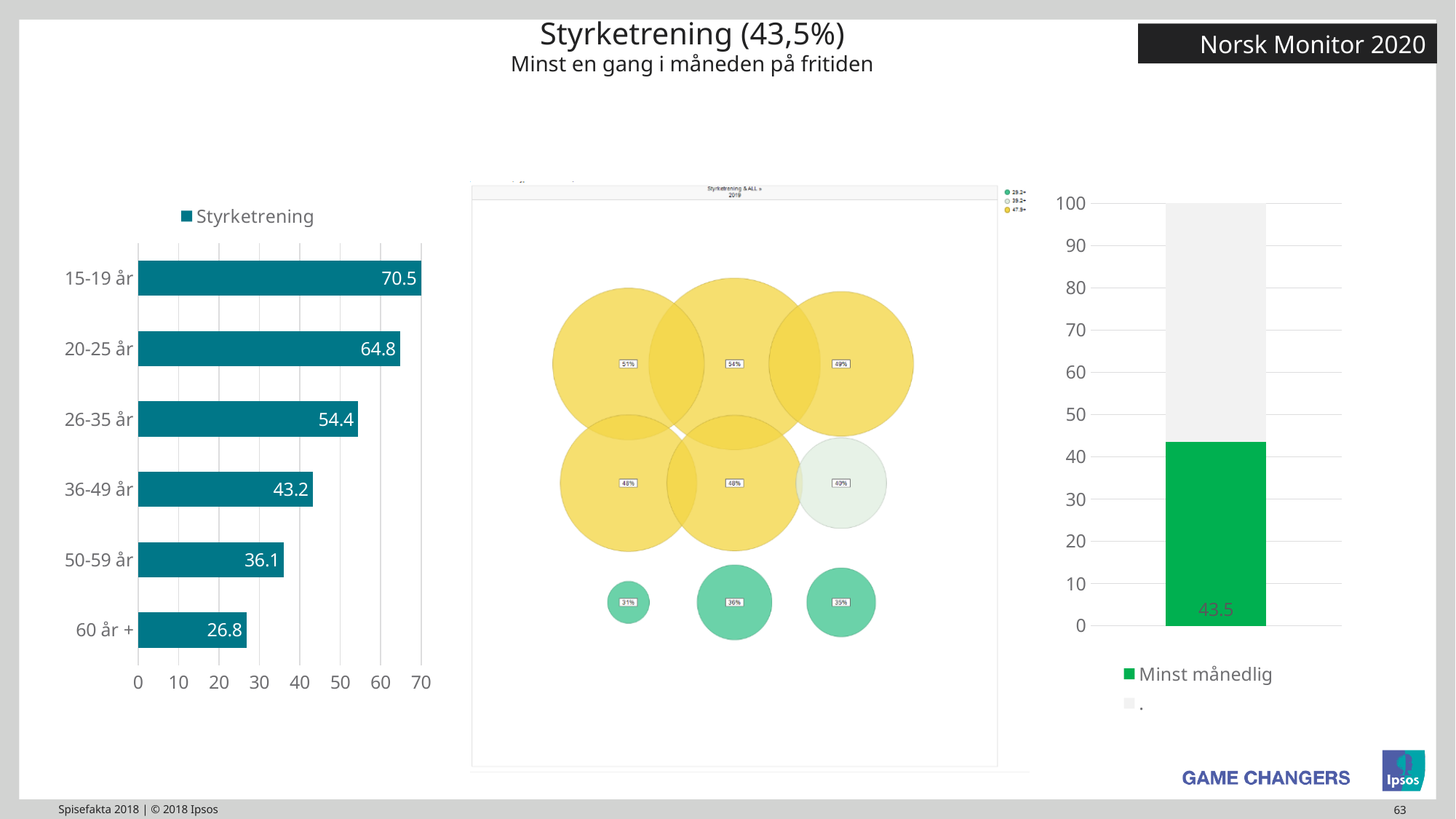
How many age groups are shown in the left bar chart? 6 In the left bar chart, what is the value for 60 år +? 26.8 What is the name of the series shown in the legend of the left bar chart? Styrketrening In the left bar chart, which is larger: the value for 50-59 år or the value for 36-49 år? 36-49 år In the left bar chart, what is the difference between the values for 20-25 år and 26-35 år? 10.4 In the left bar chart, do the values rise or fall as the age groups get older from top to bottom? Fall In the left bar chart, which age group has the lowest value? 60 år + In the left bar chart, what is the value for 36-49 år? 43.2 In the left bar chart, what is the value for 15-19 år? 70.5 In the right stacked bar chart, what is the value for Minst månedlig? 43.5 What kind of chart is the left chart on the slide? Bar chart In the left bar chart, which age group has the highest value? 15-19 år